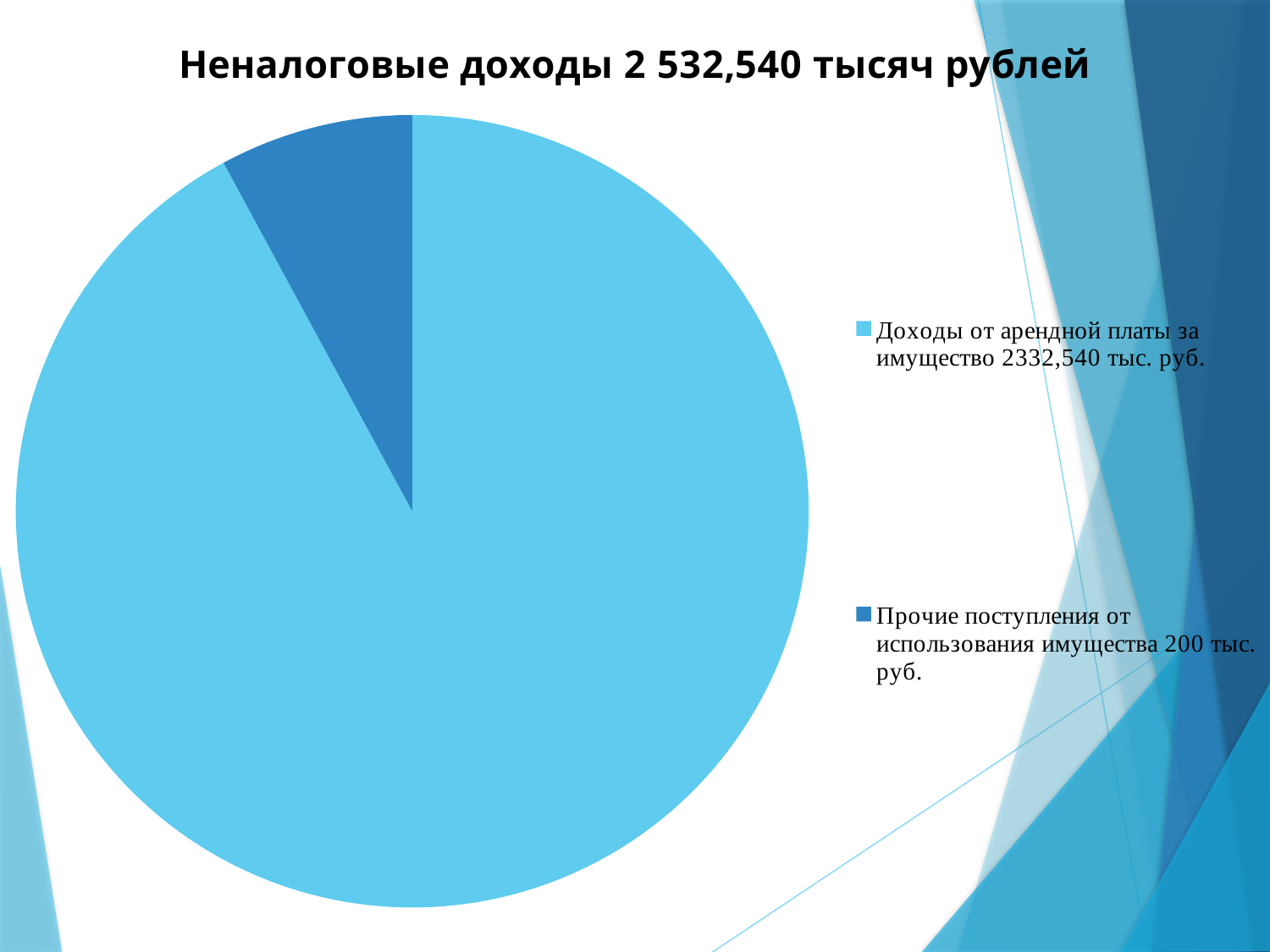
Which category has the smallest slice of the pie? Прочие поступления от использования имущества What is the total of non-tax revenues shown in the chart title? 2 532,540 тысяч рублей What is the title of the chart? Неналоговые доходы 2 532,540 тысяч рублей What is the value for Прочие поступления от использования имущества? 200 тыс. руб. Which category has the largest slice of the pie? Доходы от арендной платы за имущество What is the difference between Доходы от арендной платы за имущество and Прочие поступления от использования имущества? 2132,540 тыс. руб. Which colour represents Прочие поступления от использования имущества in the pie chart? Dark blue How many slices does the pie chart have? 2 Which is larger: Доходы от арендной платы за имущество or Прочие поступления от использования имущества? Доходы от арендной платы за имущество What is the value for Доходы от арендной платы за имущество? 2332,540 тыс. руб. How many entries does the legend list? 2 What kind of chart is shown on the slide? Pie chart